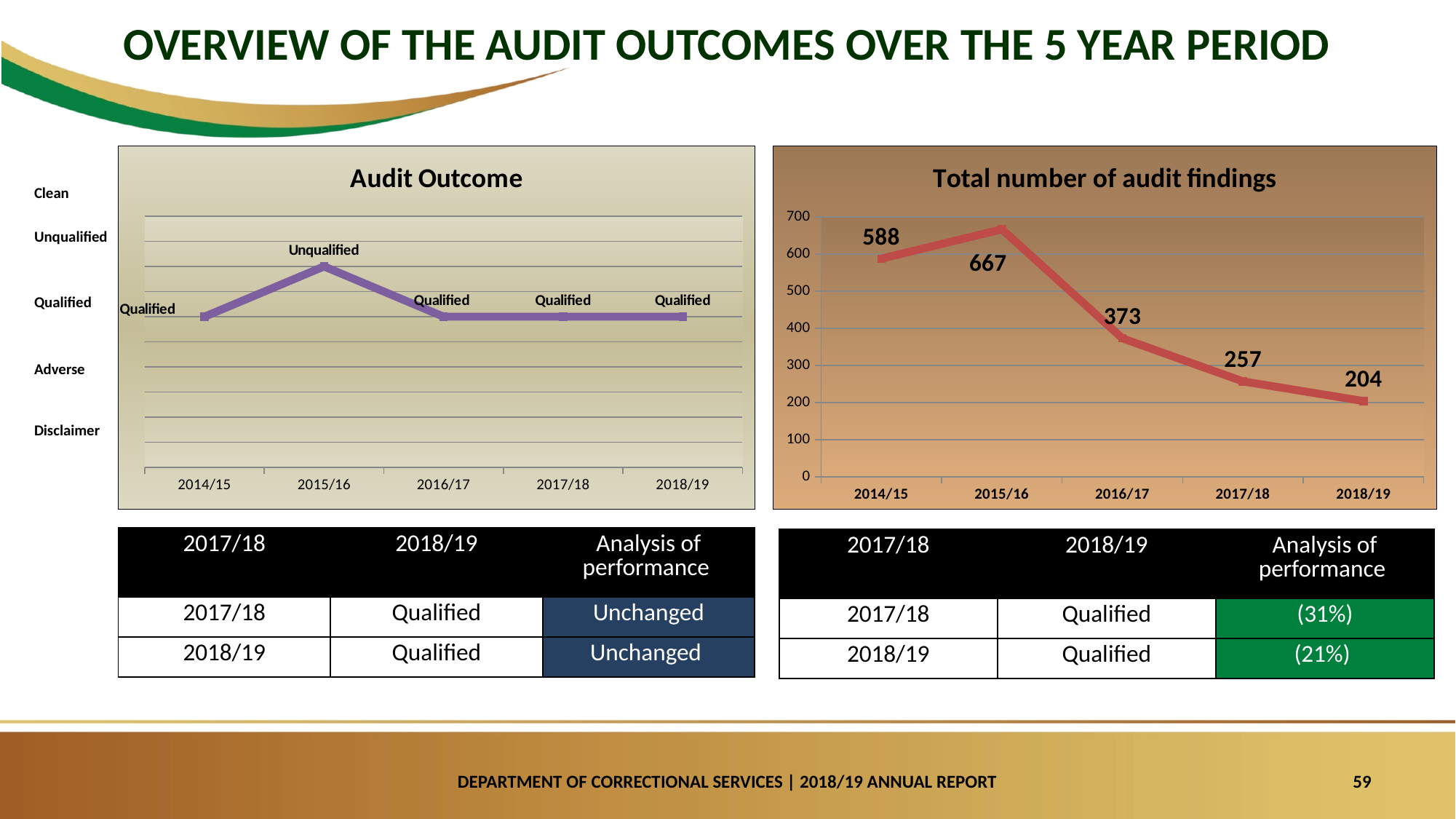
In the 'Total number of audit findings' chart, which year has the highest number of findings? 2015/16 In the 'Total number of audit findings' chart, what is the value for 2018/19? 204 In the 'Audit Outcome' chart, what is the audit outcome for 2015/16? Unqualified In the 'Total number of audit findings' chart, which year has the lowest number of findings? 2018/19 In the 'Total number of audit findings' chart, what is the value for 2015/16? 667 In the 'Total number of audit findings' chart, do the values rise or fall from 2015/16 to 2018/19? fall In the 'Audit Outcome' chart, what is the audit outcome for 2018/19? Qualified In the 'Total number of audit findings' chart, which is larger, the value for 2017/18 or the value for 2018/19? 2017/18 In the 'Total number of audit findings' chart, what is the difference between the 2014/15 and 2016/17 values? 215 What kind of chart is the 'Total number of audit findings' chart? line chart How many years are plotted in the 'Total number of audit findings' chart? 5 In the 'Total number of audit findings' chart, is the value for 2016/17 greater or less than 400? less